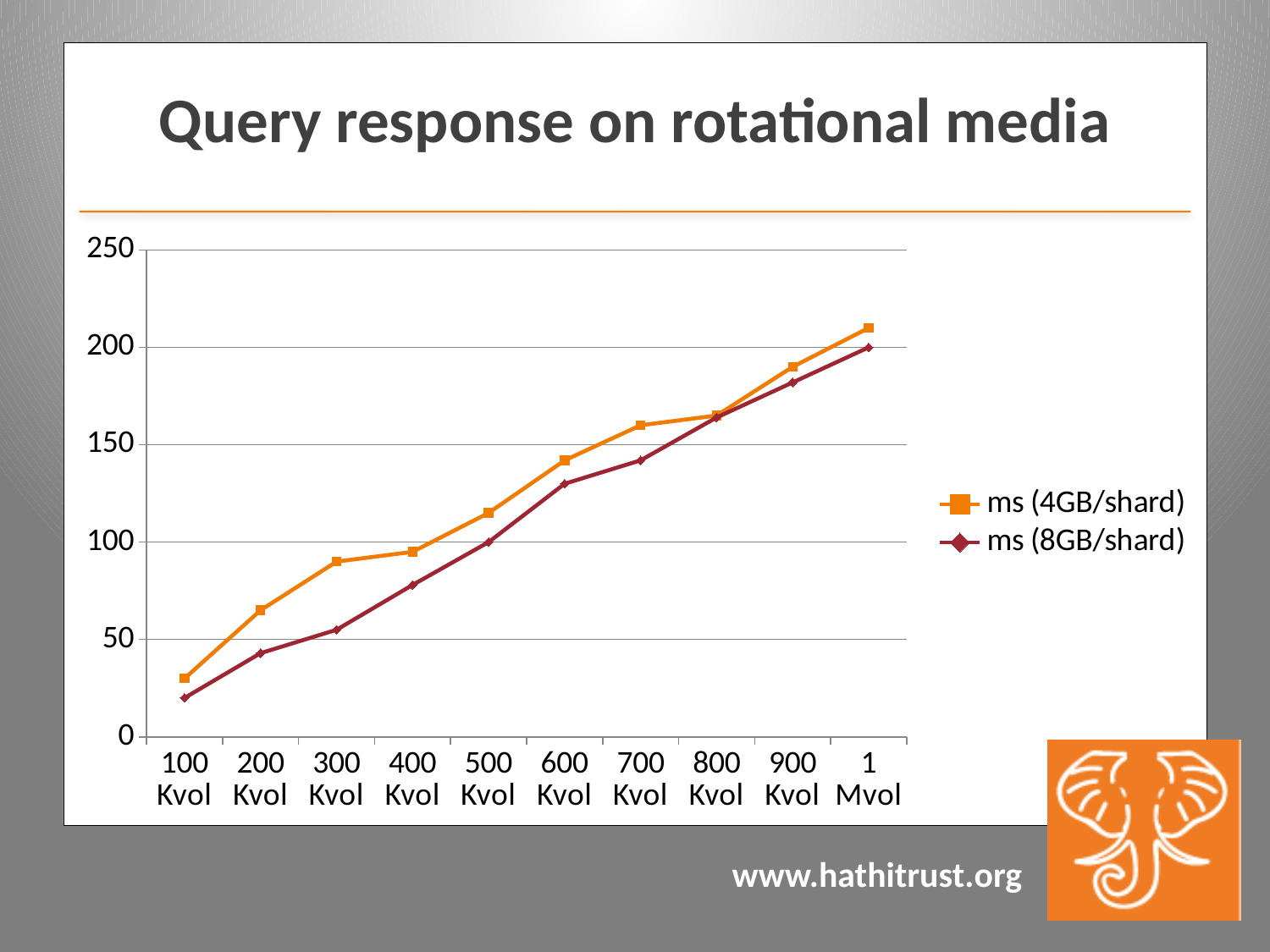
What is the title of the chart? Query response on rotational media Is the value for ms (4GB/shard) at 1 Mvol greater or less than 200? greater At which x-axis category does ms (8GB/shard) reach its highest value? 1 Mvol What kind of chart is shown on the slide? line chart How many points are plotted along the x axis for each series? 10 At 300 Kvol, which series has the larger value, ms (4GB/shard) or ms (8GB/shard)? ms (4GB/shard) Do the values for ms (4GB/shard) rise or fall as the volume increases from 100 Kvol to 1 Mvol? rise Is the value for ms (4GB/shard) at 100 Kvol greater or less than 50? less At which x-axis category is ms (4GB/shard) lowest? 100 Kvol Is the value for ms (4GB/shard) at 300 Kvol greater or less than 100? less How many series does the legend list? 2